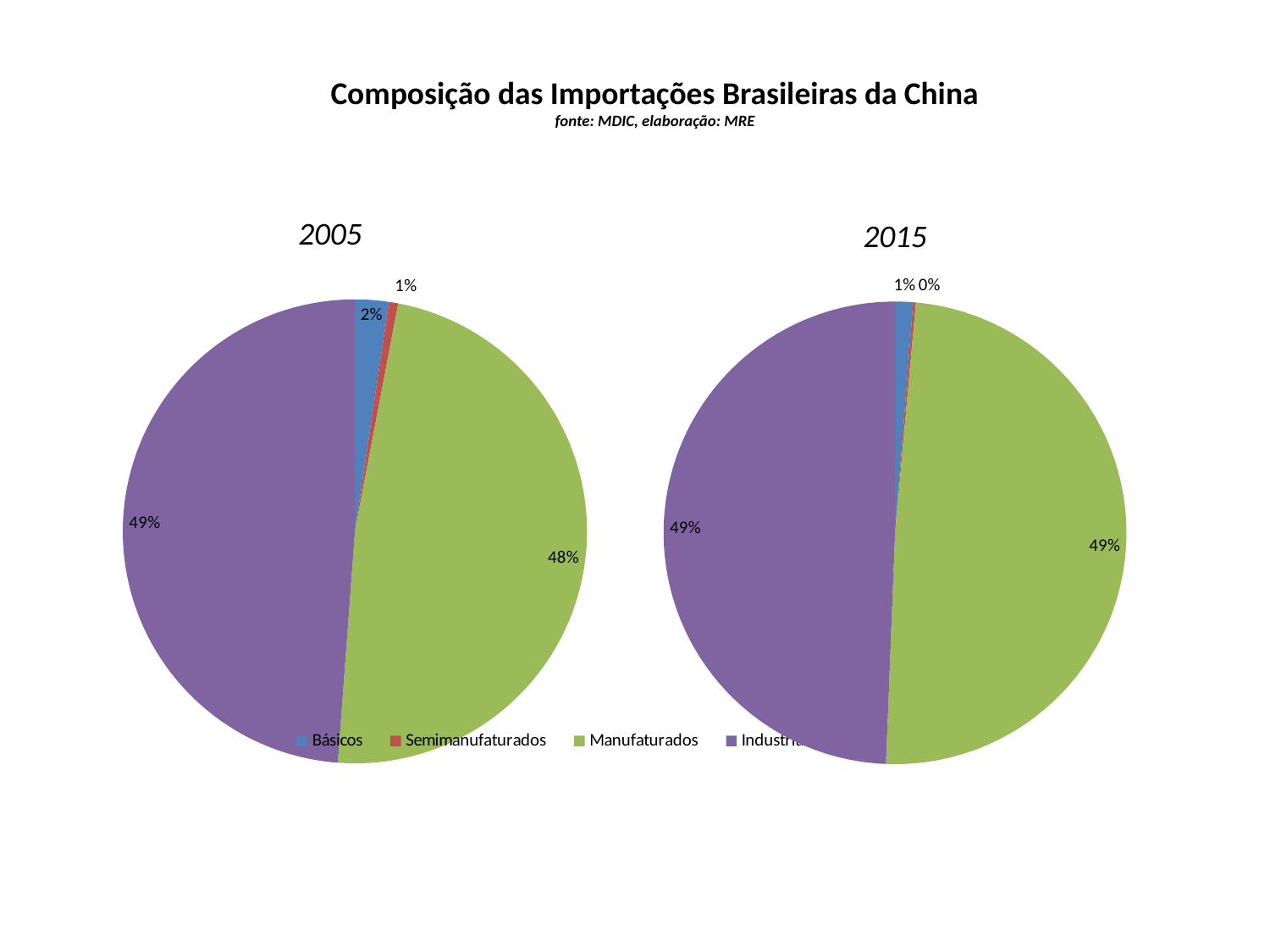
In the 2015 pie chart, what share do Semimanufaturados have? 0% In the 2015 pie chart, what share do Manufaturados have? 49% In the 2005 pie chart, which category has the smallest slice? Semimanufaturados What kind of charts are shown on the slide? Pie charts In the 2005 pie chart, what share do Básicos have? 2% By how many percentage points did the share of Manufaturados change from the 2005 pie chart to the 2015 pie chart? 1 percentage point In the 2005 pie chart, what share do Manufaturados have? 48% In the 2005 pie chart, which is larger: the share of Básicos or the share of Semimanufaturados? Básicos In the 2005 pie chart, what share do Semimanufaturados have? 1% What is the main title of the slide's charts? Composição das Importações Brasileiras da China How many slices does each pie chart have? 4 In the 2015 pie chart, what share do Básicos have? 1%